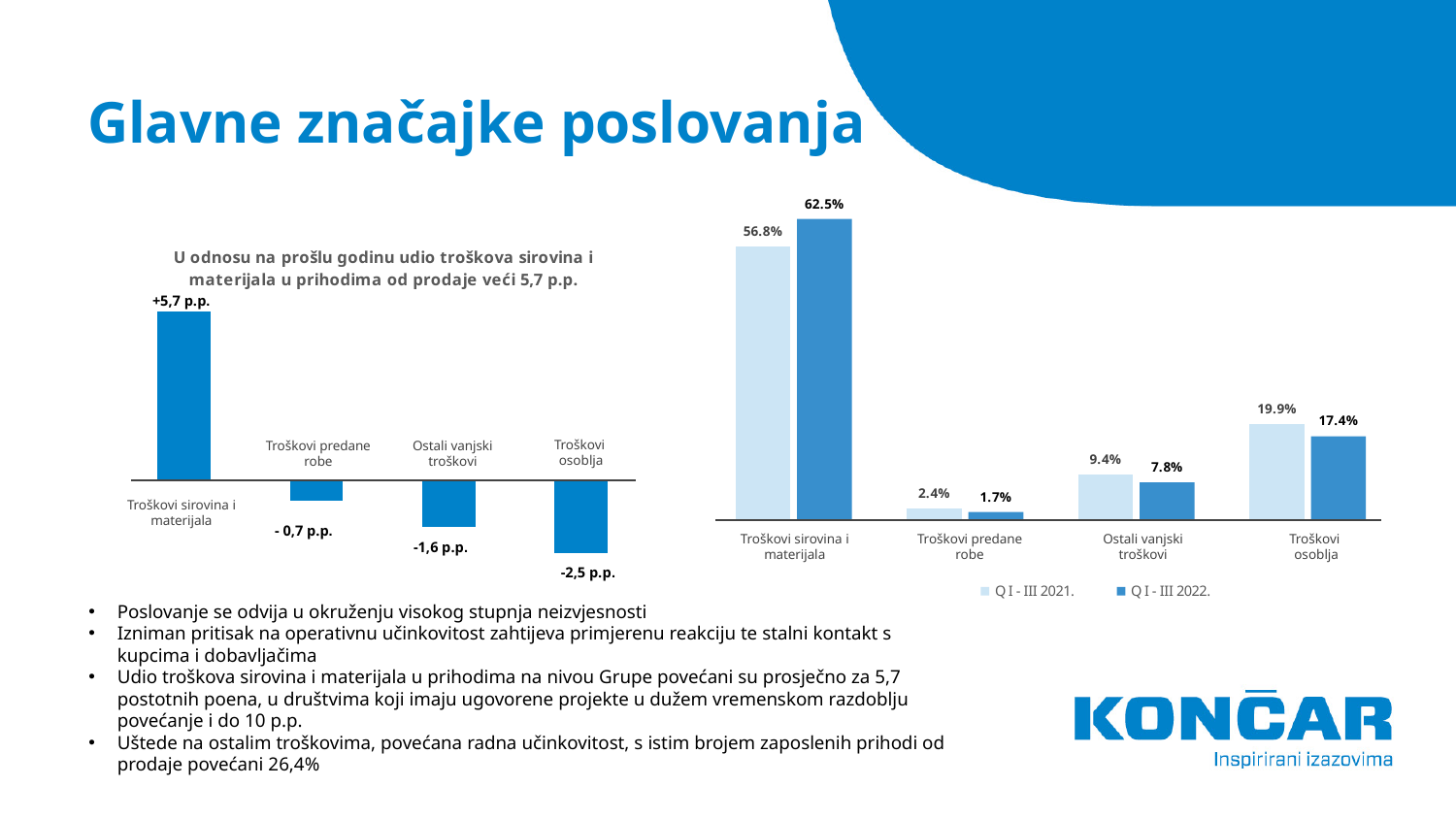
In the left chart, what is the value for Troškovi sirovina i materijala? +5,7 p.p. In the right chart, which is larger for Troškovi predane robe: Q I - III 2021. or Q I - III 2022.? Q I - III 2021. In the right chart, what is the value for Troškovi sirovina i materijala in Q I - III 2022.? 62.5% In the left chart, what is the value for Troškovi osoblja? -2,5 p.p. In the right chart, what is the value for Ostali vanjski troškovi in Q I - III 2021.? 9.4% In the left chart, how many categories are shown? 4 What is the title of the left chart? U odnosu na prošlu godinu udio troškova sirovina i materijala u prihodima od prodaje veći 5,7 p.p. What kind of chart is the right chart? Bar chart In the right chart, what is the difference between the Q I - III 2022. and Q I - III 2021. values for Troškovi osoblja? 2.5% In the right chart, which category has the highest value in Q I - III 2021.? Troškovi sirovina i materijala In the left chart, which category has the lowest value? Troškovi osoblja How many series does the legend of the right chart list? 2